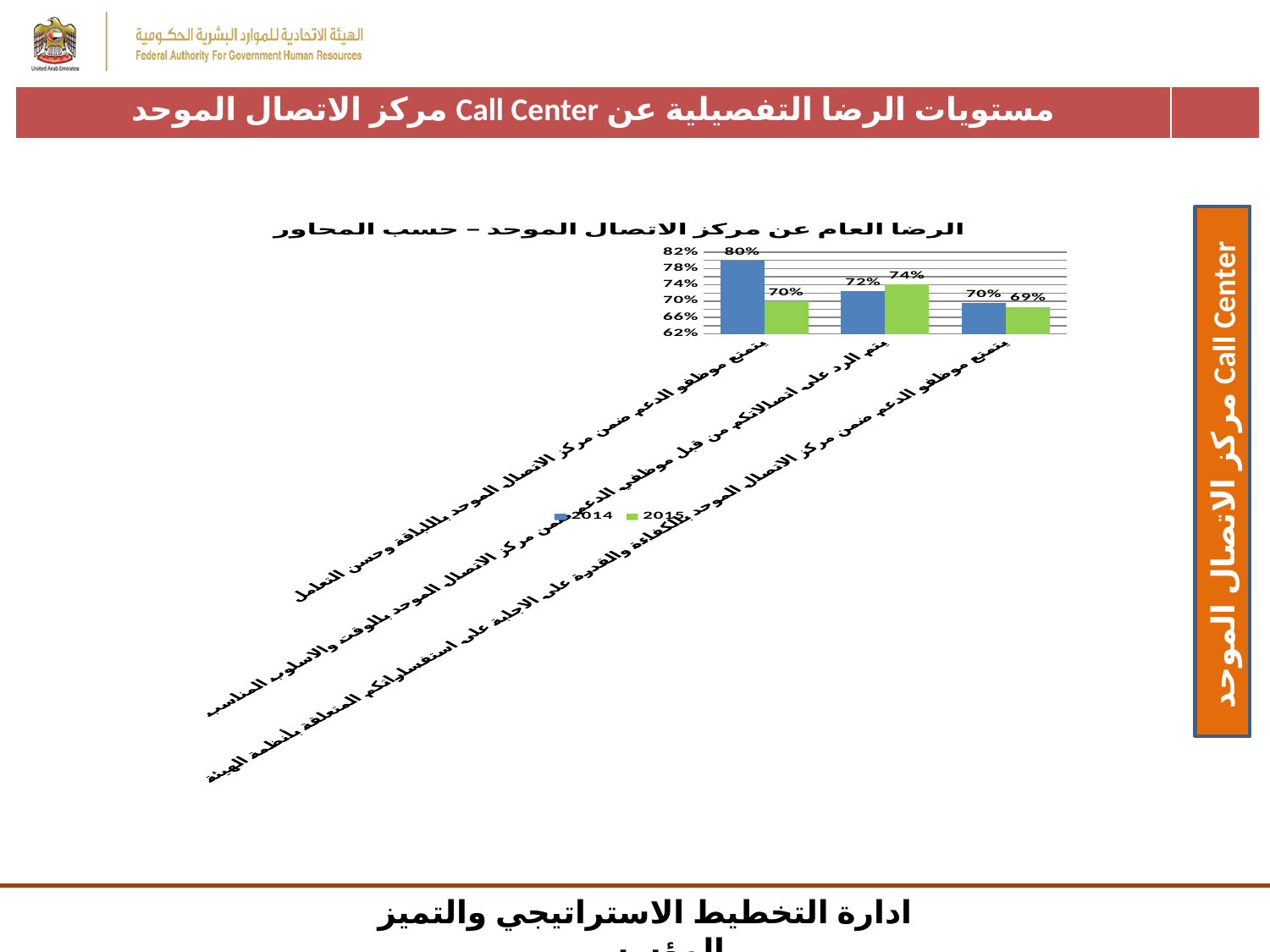
What is the difference between the 2014 and 2015 values for the first (leftmost) category? 10 percentage points What kind of chart is shown on the slide? Bar chart What is the 2014 value for the first (leftmost) category in the chart? 80% What is the 2014 value for the second (middle) category in the chart? 72% How many series does the chart legend list? 2 For the second (middle) category, which series has the larger value, 2014 or 2015? 2015 What is the 2015 value for the first (leftmost) category in the chart? 70% How many categories are plotted on the x axis of the chart? 3 What is the 2015 value for the second (middle) category in the chart? 74% What are the two series named in the chart legend? 2014 and 2015 What is the 2015 value for the third (rightmost) category in the chart? 69% Which category has the highest 2014 value in the chart? The first (leftmost) category